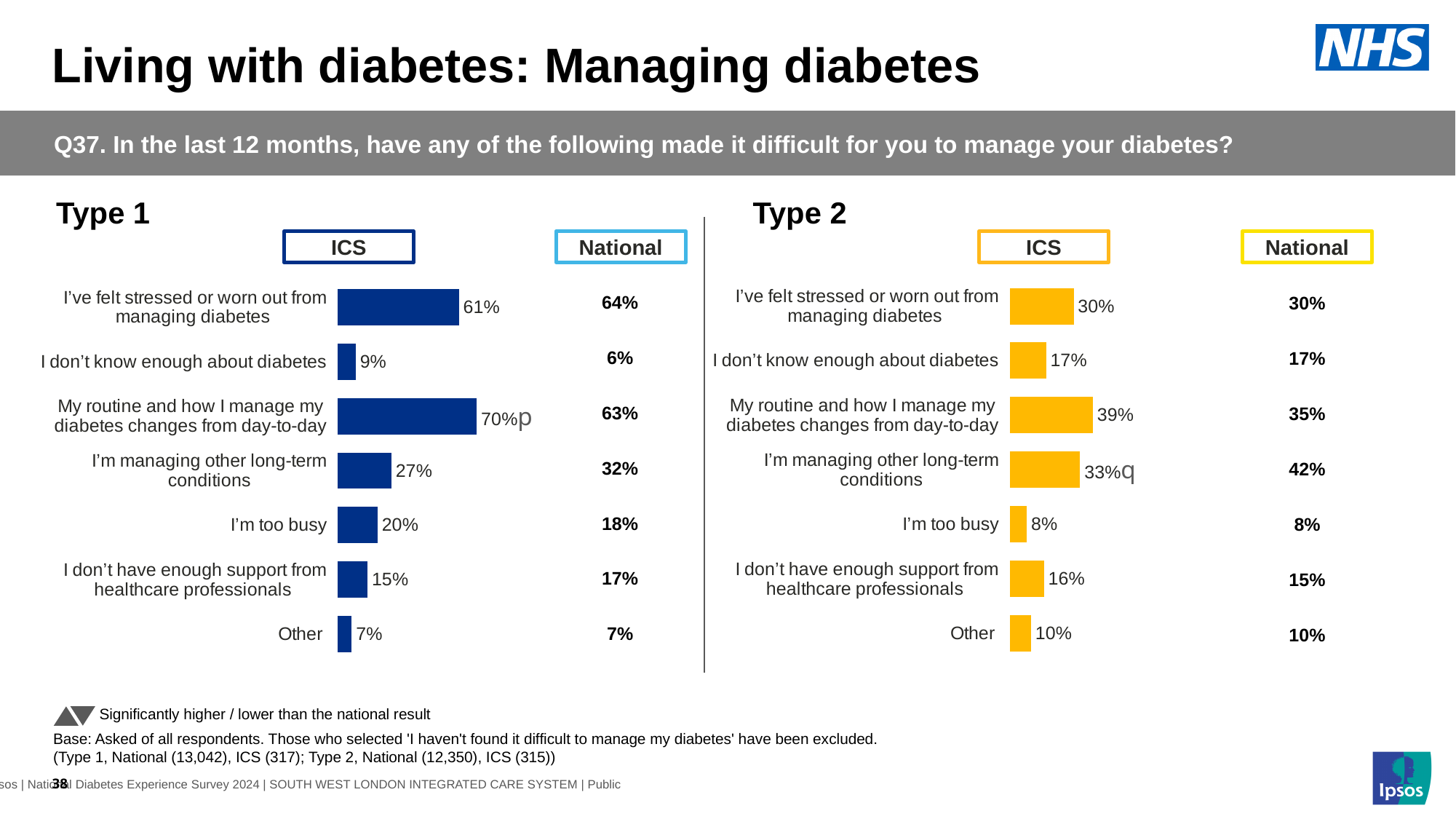
In the Type 2 chart, which category has the lowest ICS value? I'm too busy In the Type 1 chart, what is the difference between the ICS values for 'I've felt stressed or worn out from managing diabetes' and 'I'm managing other long-term conditions'? 34 percentage points In the Type 1 chart, what is the National value for 'I'm managing other long-term conditions'? 32% In the Type 2 chart, what is the ICS value for 'My routine and how I manage my diabetes changes from day-to-day'? 39% What colour are the bars in the Type 2 chart? Yellow/orange How many categories are shown in the Type 2 chart? 7 In the Type 1 chart, which category has the highest ICS value? My routine and how I manage my diabetes changes from day-to-day In the Type 2 chart, which is larger: the ICS value for 'I don't have enough support from healthcare professionals' or the ICS value for 'Other'? I don't have enough support from healthcare professionals In the Type 1 chart, what is the ICS value for 'I'm too busy'? 20% In the Type 2 chart, what is the difference between the National and ICS values for 'I'm managing other long-term conditions'? 9 percentage points What type of chart is used for the Type 1 ICS results? Bar chart In the Type 1 chart, is the ICS value for 'I don't know enough about diabetes' larger or smaller than the National value? larger